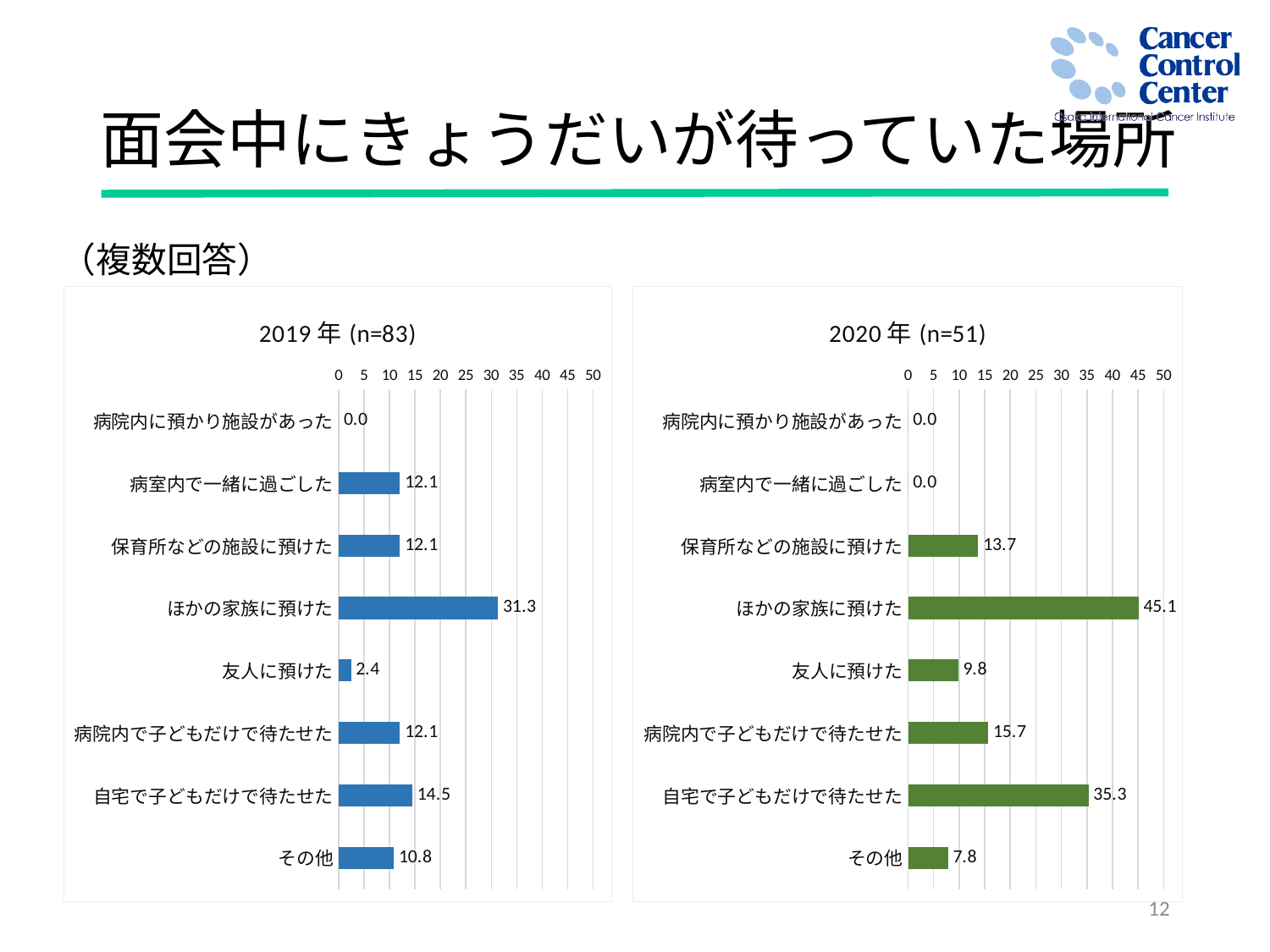
In the 2019年 (n=83) chart, which category has the highest value? ほかの家族に預けた In the 2020年 (n=51) chart, which category has the highest value? ほかの家族に預けた In the 2019年 (n=83) chart, what is the value for ほかの家族に預けた? 31.3 In the 2020年 (n=51) chart, what is the difference between ほかの家族に預けた and 自宅で子どもだけで待たせた? 9.8 How many categories are shown in the 2019年 (n=83) chart? 8 In the 2019年 (n=83) chart, what is the difference between 自宅で子どもだけで待たせた and その他? 3.7 In the 2019年 (n=83) chart, which category has the lowest value? 病院内に預かり施設があった In the 2020年 (n=51) chart, which is larger: 病院内で子どもだけで待たせた or 保育所などの施設に預けた? 病院内で子どもだけで待たせた In the 2020年 (n=51) chart, what is the value for 自宅で子どもだけで待たせた? 35.3 What is the title of the chart on the left side of the slide? 2019年 (n=83) What type of chart is the 2020年 (n=51) chart? bar chart In the 2020年 (n=51) chart, what is the value for 友人に預けた? 9.8